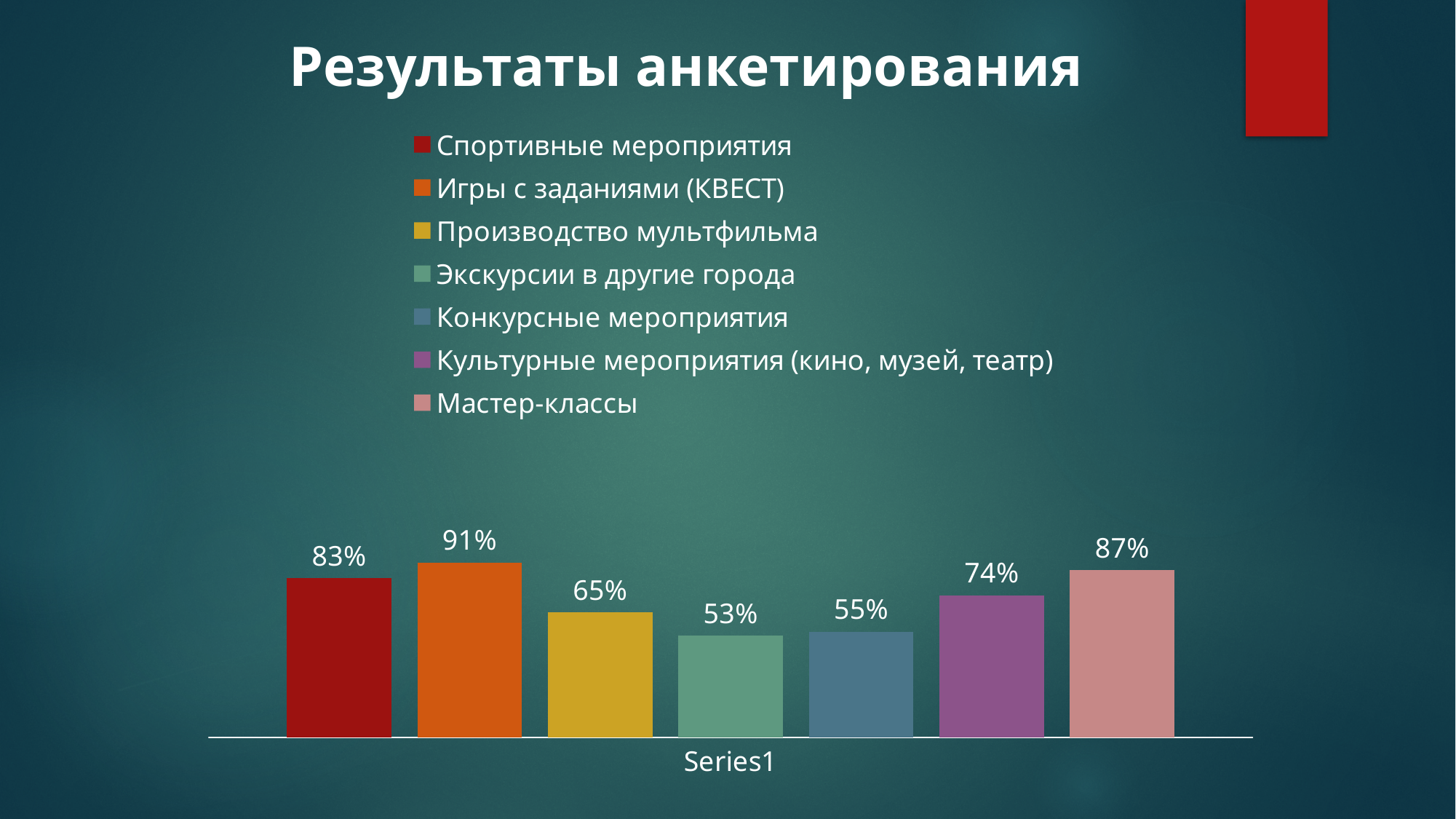
What kind of chart is shown on the slide? Bar chart What value is shown for Игры с заданиями (КВЕСТ)? 91% Which legend entry has the lowest value? Экскурсии в другие города How many bars are plotted in the chart? 7 What is the difference between the values for Игры с заданиями (КВЕСТ) and Производство мультфильма? 26% Which legend entry has the highest value? Игры с заданиями (КВЕСТ) What is the title of the slide? Результаты анкетирования What value is shown for Спортивные мероприятия? 83% Which is larger, the value for Культурные мероприятия (кино, музей, театр) or the value for Конкурсные мероприятия? Культурные мероприятия (кино, музей, театр) What value is shown for Мастер-классы? 87% How many entries does the legend list? 7 What value is shown for Экскурсии в другие города? 53%